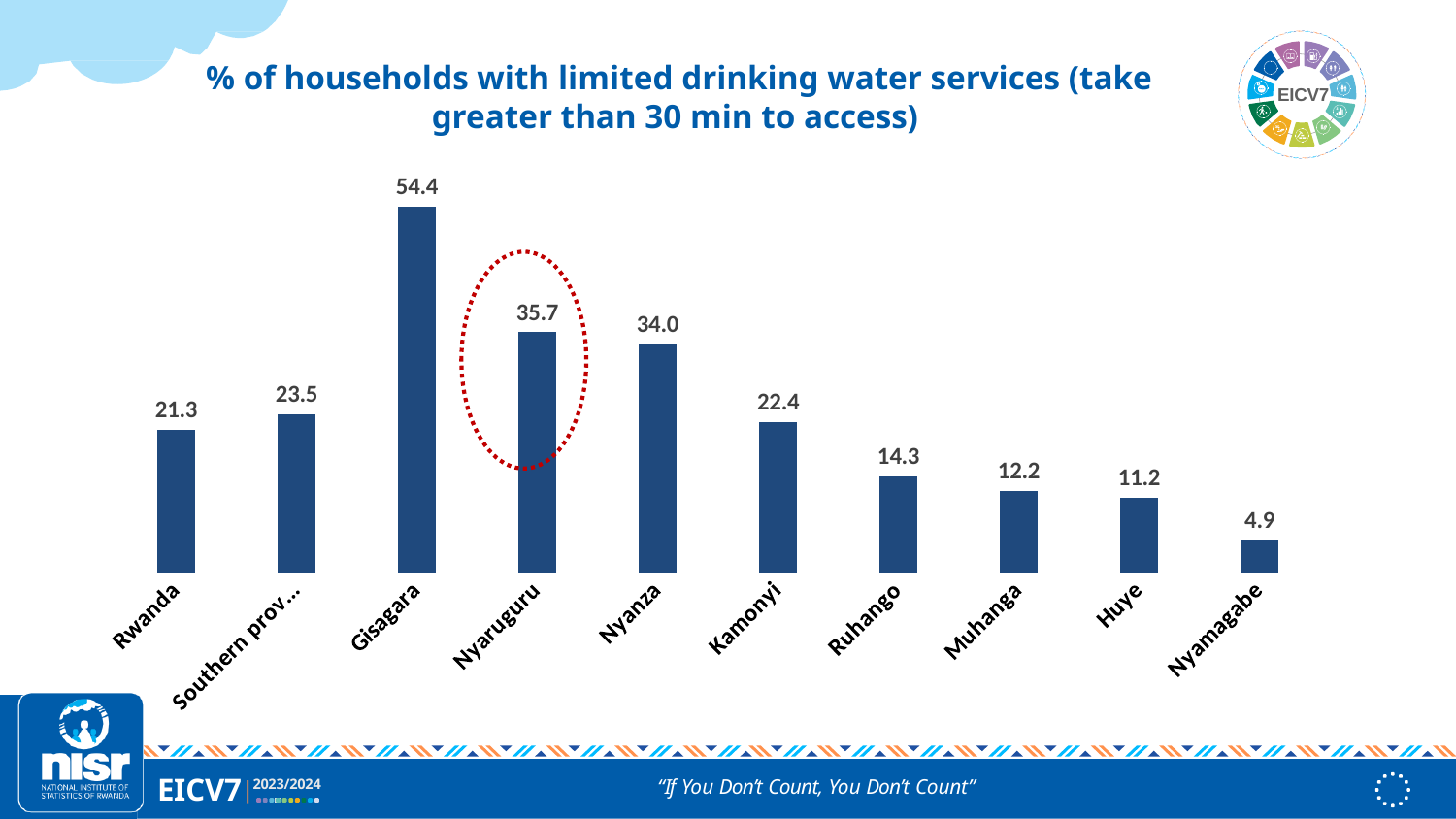
Do the values rise or fall from Nyanza to Nyamagabe along the x axis? Fall What is the value for Nyaruguru, the bar circled in red? 35.7 Which is larger, the value for Kamonyi or the value for Ruhango? Kamonyi Which bar is highlighted with a red dotted circle? Nyaruguru Which category has the highest value? Gisagara What is the value for Rwanda? 21.3 How many categories are shown on the x axis? 10 Which category has the lowest value? Nyamagabe What is the value for Gisagara? 54.4 What is the value for Nyamagabe? 4.9 What kind of chart is shown on the slide? Bar chart What is the difference between the values for Gisagara and Nyaruguru? 18.7